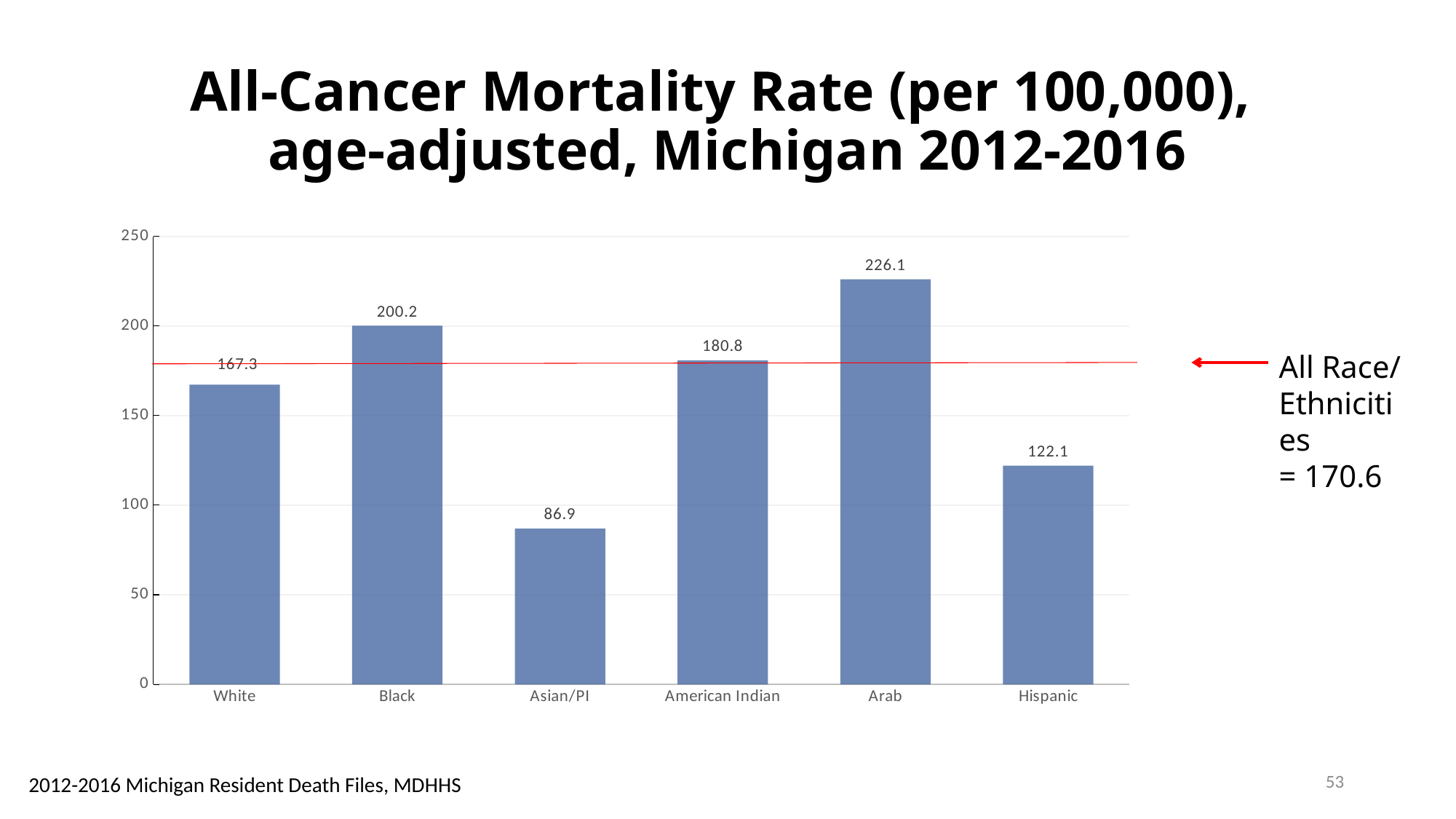
What is the difference between the mortality rates for Arab and White? 58.8 Which category has the lowest all-cancer mortality rate? Asian/PI What is the all-cancer mortality rate for the Hispanic category? 122.1 Is the value for White greater or less than 150? greater What is the all-cancer mortality rate for the Black category? 200.2 What is the data source cited at the bottom of the slide? 2012-2016 Michigan Resident Death Files, MDHHS Which has a higher mortality rate, American Indian or Hispanic? American Indian What is the All Race/Ethnicities rate indicated by the red reference line? 170.6 What is the all-cancer mortality rate for the Asian/PI category? 86.9 How many race/ethnicity categories are shown on the x axis? 6 Which category has the highest all-cancer mortality rate? Arab What kind of chart is shown on the slide? Bar chart